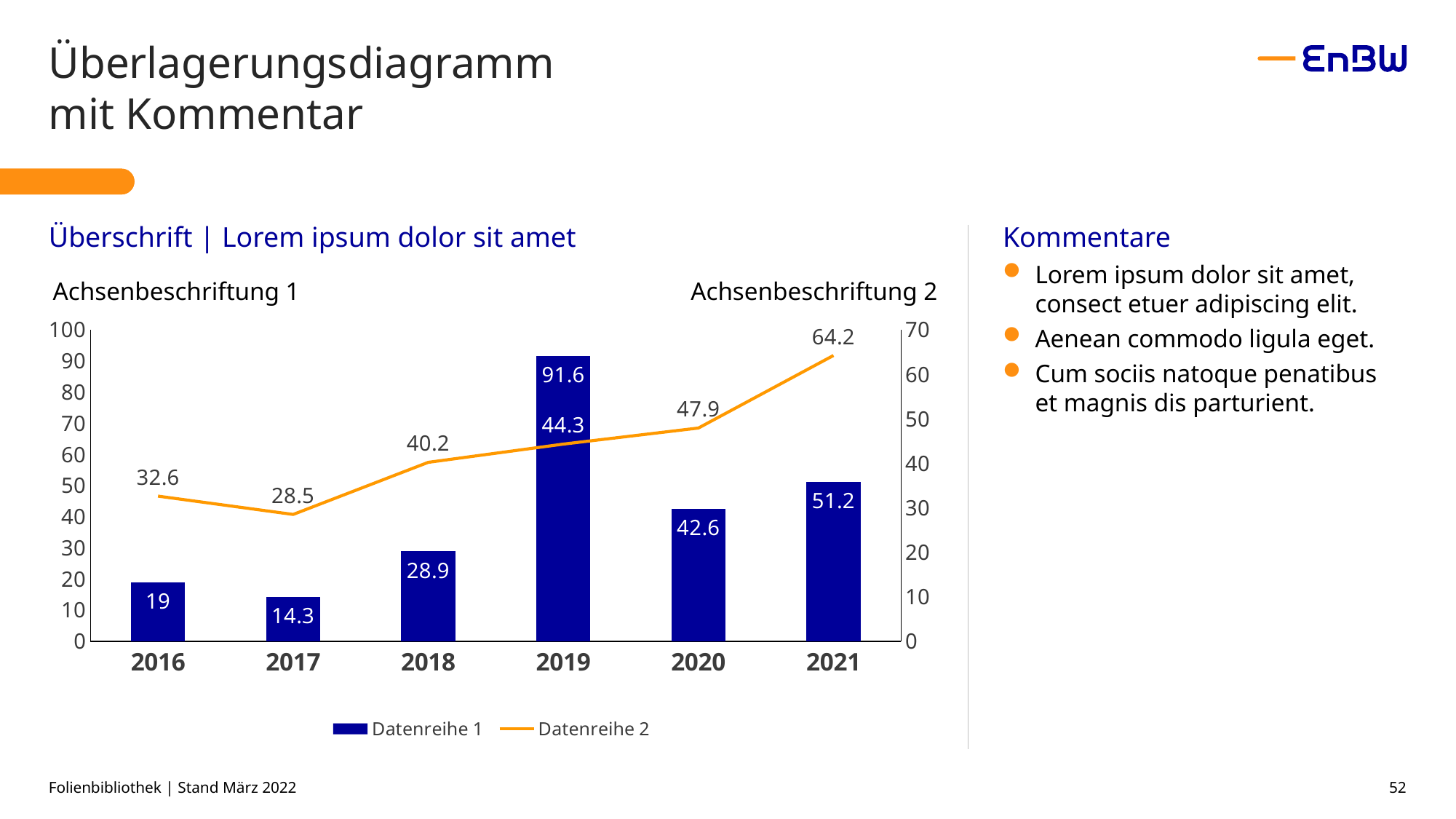
What is the value of Datenreihe 1 for 2019? 91.6 What kind of chart is shown? Combined bar and line chart Which year has the highest value for Datenreihe 1? 2019 What is the difference between the Datenreihe 1 values for 2021 and 2020? 8.6 What is the value of Datenreihe 1 for 2017? 14.3 How many series does the legend list? 2 How many years are shown on the x axis? 6 Is the Datenreihe 1 value for 2020 greater or less than 50 on the left axis? less Does Datenreihe 2 rise or fall from 2017 to 2021? rise Which is larger, the Datenreihe 2 value for 2018 or for 2019? 2019 Which year has the lowest value for Datenreihe 2? 2017 What is the value of Datenreihe 2 for 2021? 64.2